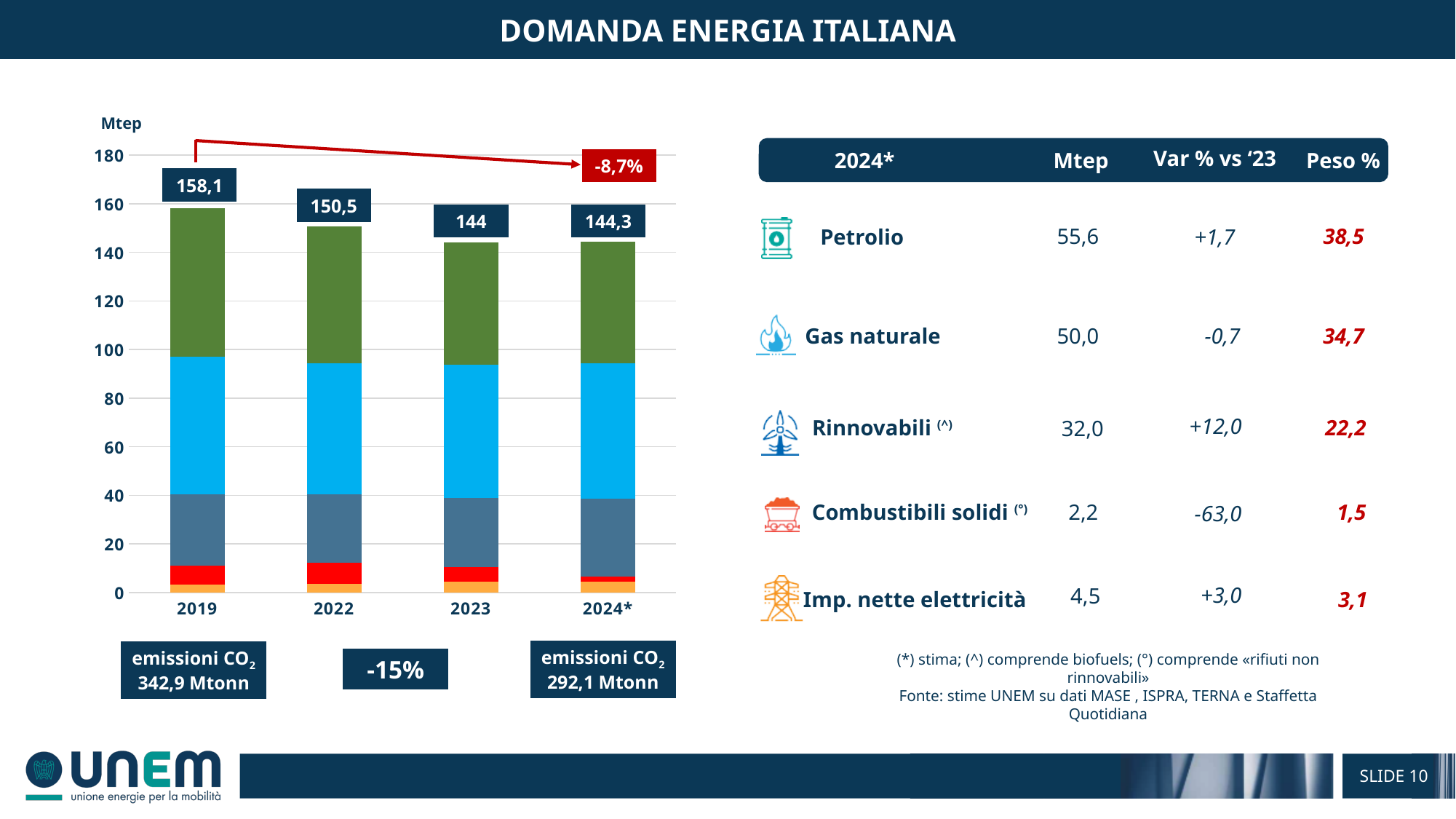
Which year has the highest total in the bar chart? 2019 Which has the larger total in the bar chart, 2022 or 2023? 2022 What is the difference between the totals for 2019 and 2022 in the bar chart? 7,6 What is the total value shown for 2022 in the bar chart? 150,5 Which year has the lowest total in the bar chart? 2023 How many years (bars) are shown in the bar chart? 4 What is the total value shown for 2019 in the bar chart? 158,1 What percentage change is shown by the red arrow annotation from 2019 to 2024* in the bar chart? -8,7% What is the difference between the totals for 2019 and 2024* in the bar chart? 13,8 What kind of chart is shown on the slide? Stacked bar chart What is the total value shown for 2024* in the bar chart? 144,3 Do the bar totals generally rise or fall from 2019 to 2024*? Fall